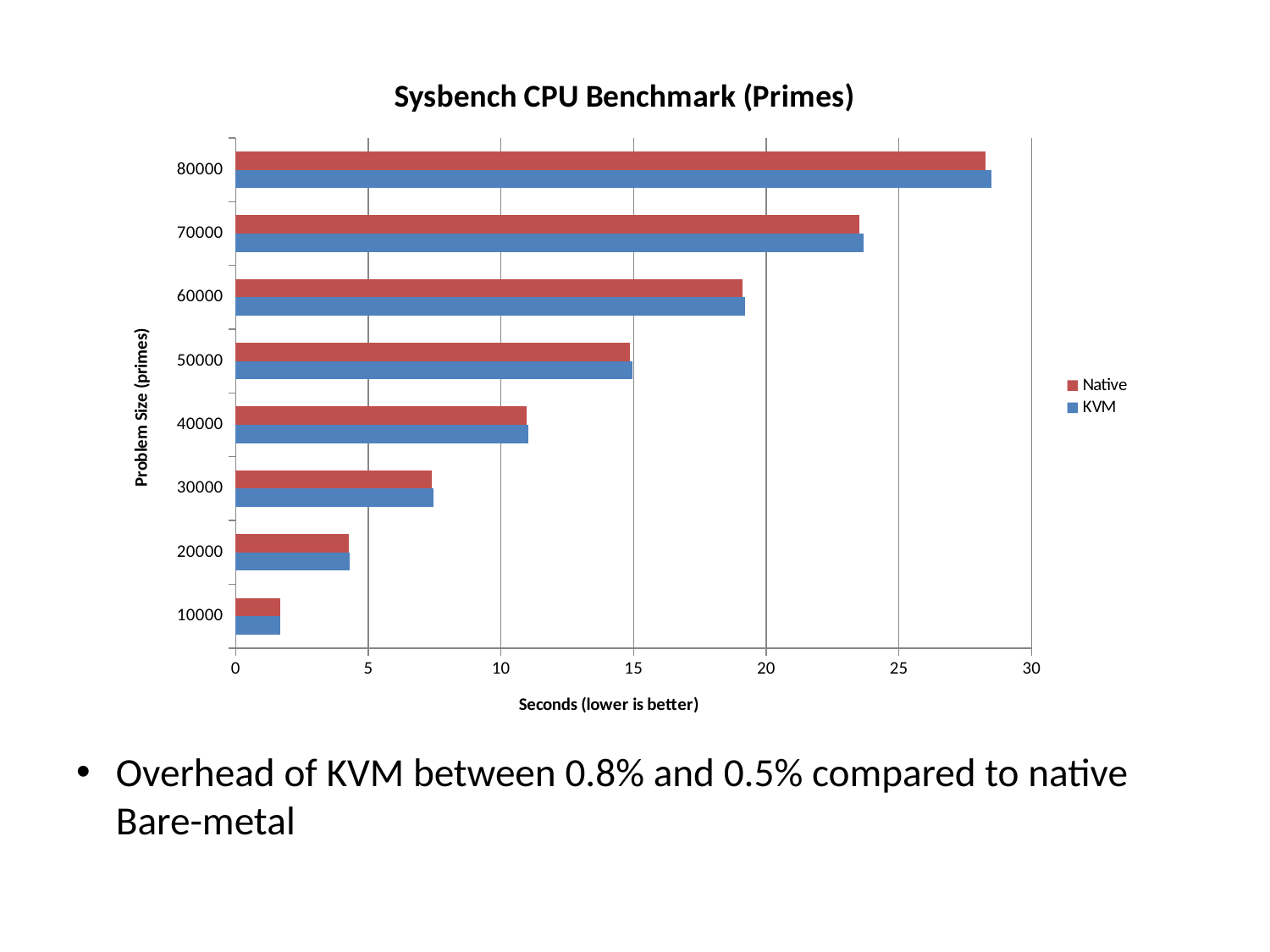
Which problem size has the lowest KVM time? 10000 Is the KVM value for 60000 primes greater or less than 20 seconds? less What is the label of the horizontal axis? Seconds (lower is better) How many problem sizes are plotted on the chart? 8 Which problem size has the highest Native time? 80000 Do the benchmark times rise or fall as the problem size increases? rise What is the title of the chart? Sysbench CPU Benchmark (Primes) What kind of chart is shown on the slide? bar chart Is the KVM value for 10000 primes greater or less than 5 seconds? less Is the Native value for 80000 primes greater or less than 25 seconds? greater How many series does the legend list? 2